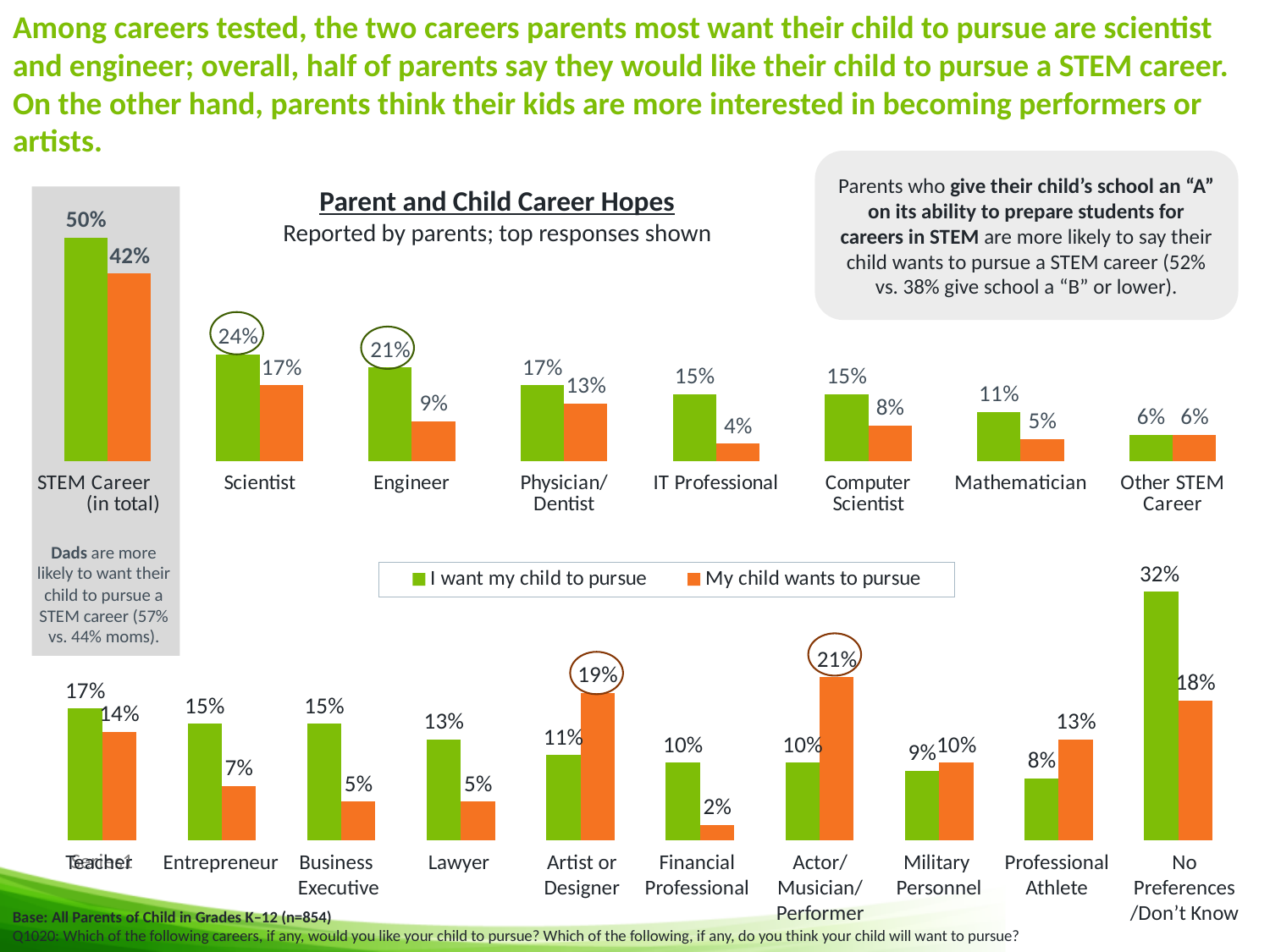
What is the title of the chart? Parent and Child Career Hopes Among the individual careers (excluding STEM Career in total and No Preferences/Don't Know), which career has the highest 'I want my child to pursue' value? Scientist What percentage of parents say their child wants to pursue a career as an Engineer? 9% How many series does the legend list? 2 What percentage of parents say they want their child to pursue a career as a Scientist? 24% What is the difference between the 'I want my child to pursue' and 'My child wants to pursue' values for IT Professional? 11 percentage points What is the value for 'I want my child to pursue' for a STEM Career (in total)? 50% What is the value for 'My child wants to pursue' for Actor/Musician/Performer? 21% Which colour represents the 'My child wants to pursue' series? Orange Which career has the lowest 'My child wants to pursue' value? Financial Professional For Artist or Designer, which is larger: 'I want my child to pursue' or 'My child wants to pursue'? My child wants to pursue What kind of chart is shown on the slide? Bar chart